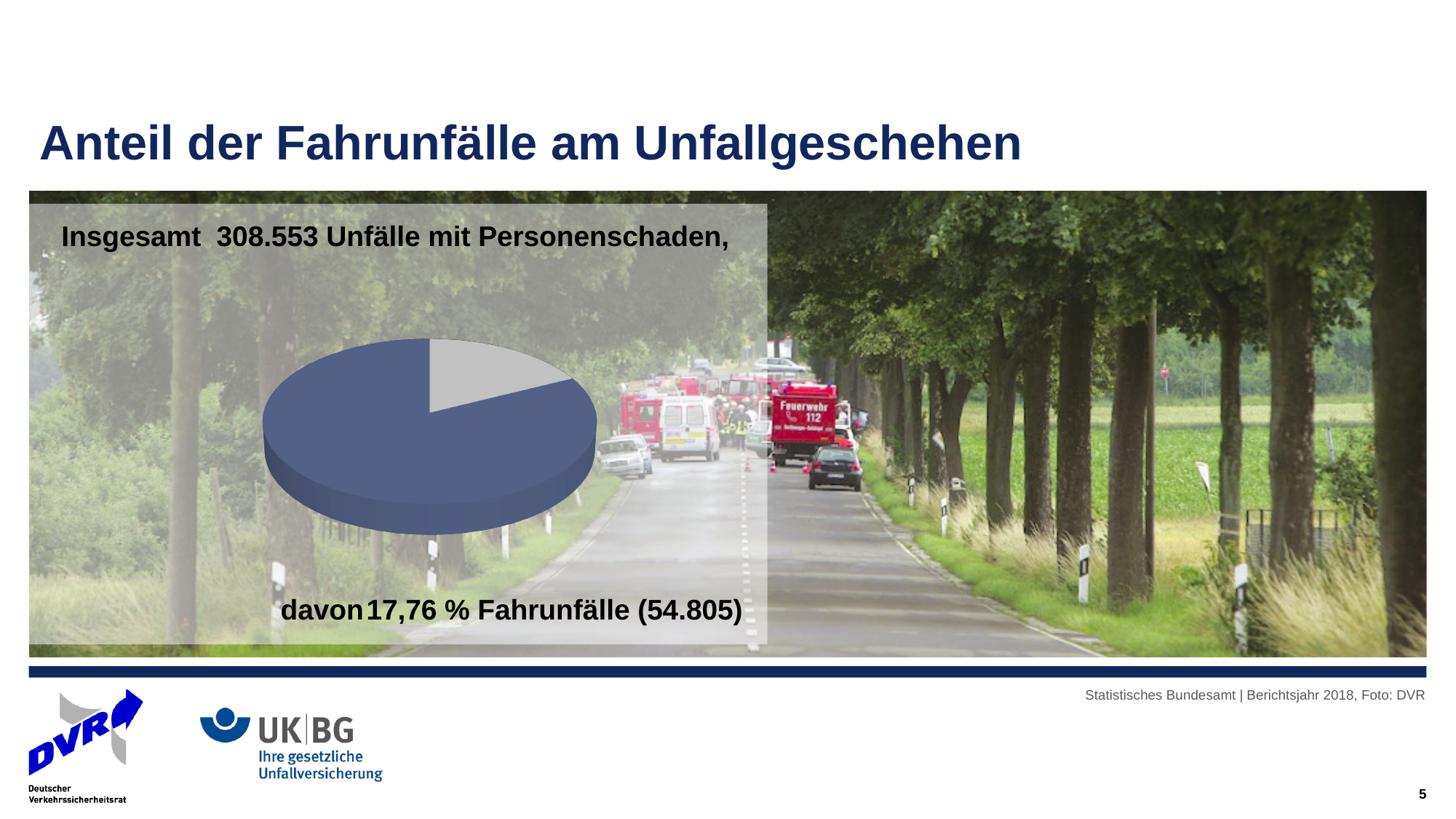
Does the grey slice represent more or less than half of the pie? less How many slices does the pie chart have? 2 What kind of chart is shown on the slide? pie chart What is the title of the slide containing the pie chart? Anteil der Fahrunfälle am Unfallgeschehen How many Fahrunfälle are stated on the slide? 54.805 What colour is the larger slice of the pie chart? blue Which slice of the pie chart is larger, the blue one or the grey one? the blue one According to the slide, what share of the accidents are Fahrunfälle? 17,76 % What is the total number of Unfälle mit Personenschaden stated on the slide? 308.553